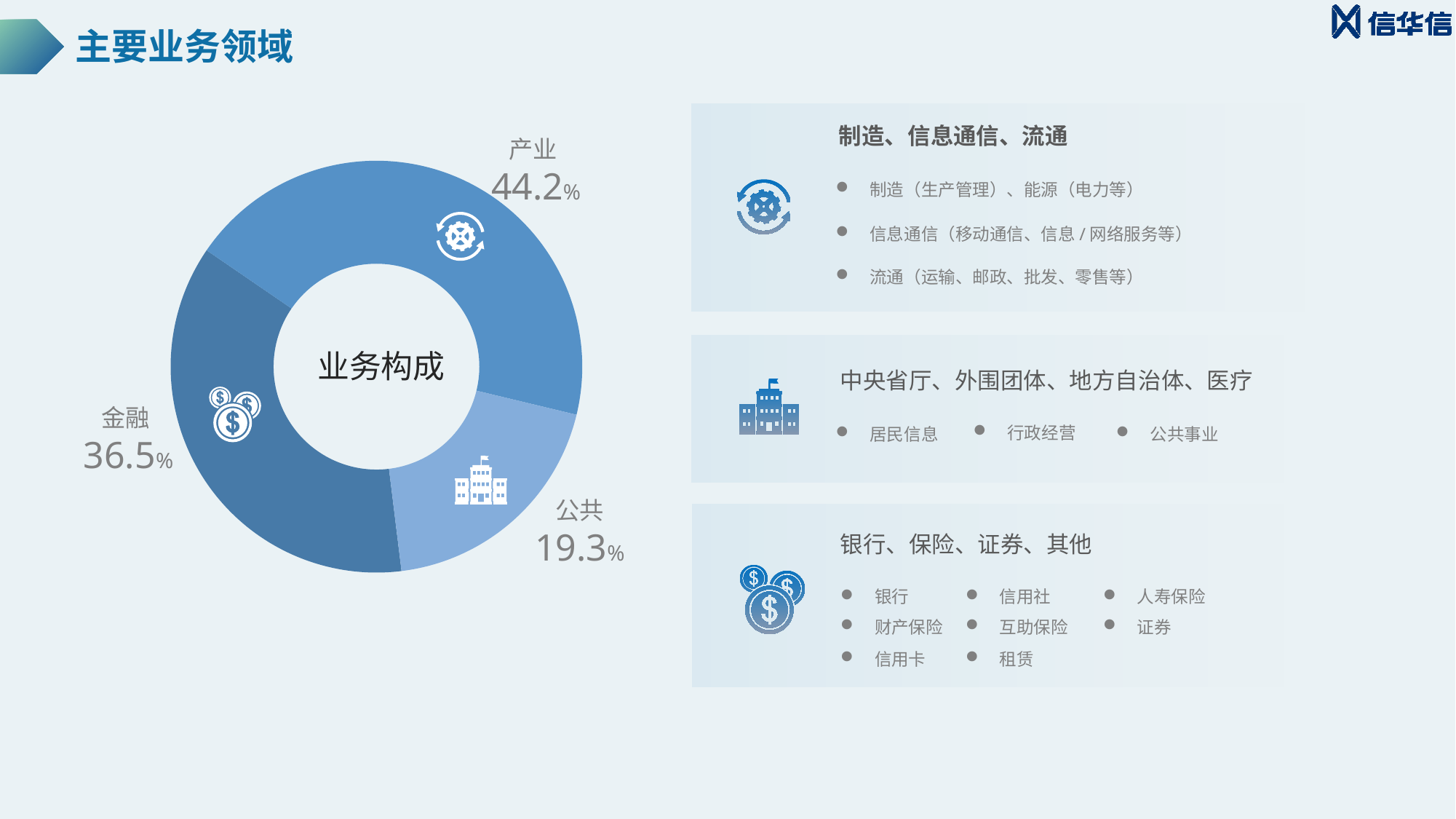
What kind of chart is the 业务构成 chart? Donut (pie) chart Which segment of the 业务构成 chart is the smallest? 公共 What share of the 业务构成 donut chart is 金融? 36.5% What is the combined share of 产业 and 公共 in the 业务构成 chart? 63.5% In the 业务构成 chart, which is larger, 金融 or 公共? 金融 What share of the 业务构成 donut chart is 公共? 19.3% In the 业务构成 chart, what is the difference between the 产业 share and the 金融 share? 7.7% How many segments does the 业务构成 chart have? 3 Which segment of the 业务构成 chart is the largest? 产业 In the 业务构成 chart, what is the difference between the 金融 share and the 公共 share? 17.2% What text is shown in the centre of the donut chart? 业务构成 What share of the 业务构成 donut chart is 产业? 44.2%